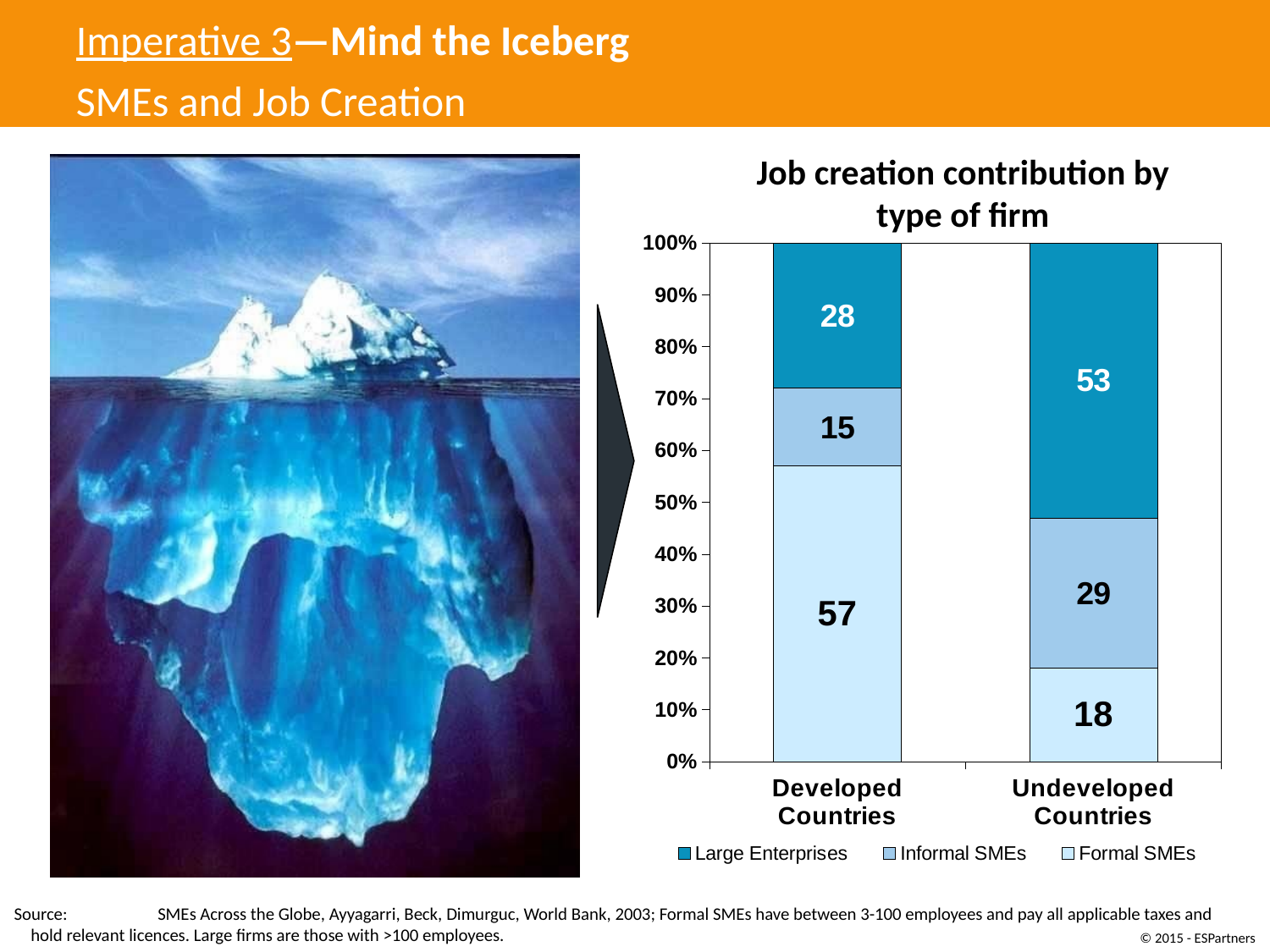
What is the difference between the Large Enterprises values for Undeveloped Countries and Developed Countries? 25 How many series does the legend list? 3 What is the value for Formal SMEs in Developed Countries? 57 What is the value for Informal SMEs in Developed Countries? 15 Which type of firm contributes the least to job creation in Undeveloped Countries? Formal SMEs Which type of firm contributes the most to job creation in Developed Countries? Formal SMEs What is the value for Large Enterprises in Undeveloped Countries? 53 Which is larger: the Formal SMEs value for Developed Countries or for Undeveloped Countries? Developed Countries What is the title of the chart? Job creation contribution by type of firm What is the value for Informal SMEs in Undeveloped Countries? 29 How many country categories are shown on the x axis? 2 What kind of chart is shown on the slide? Stacked bar chart